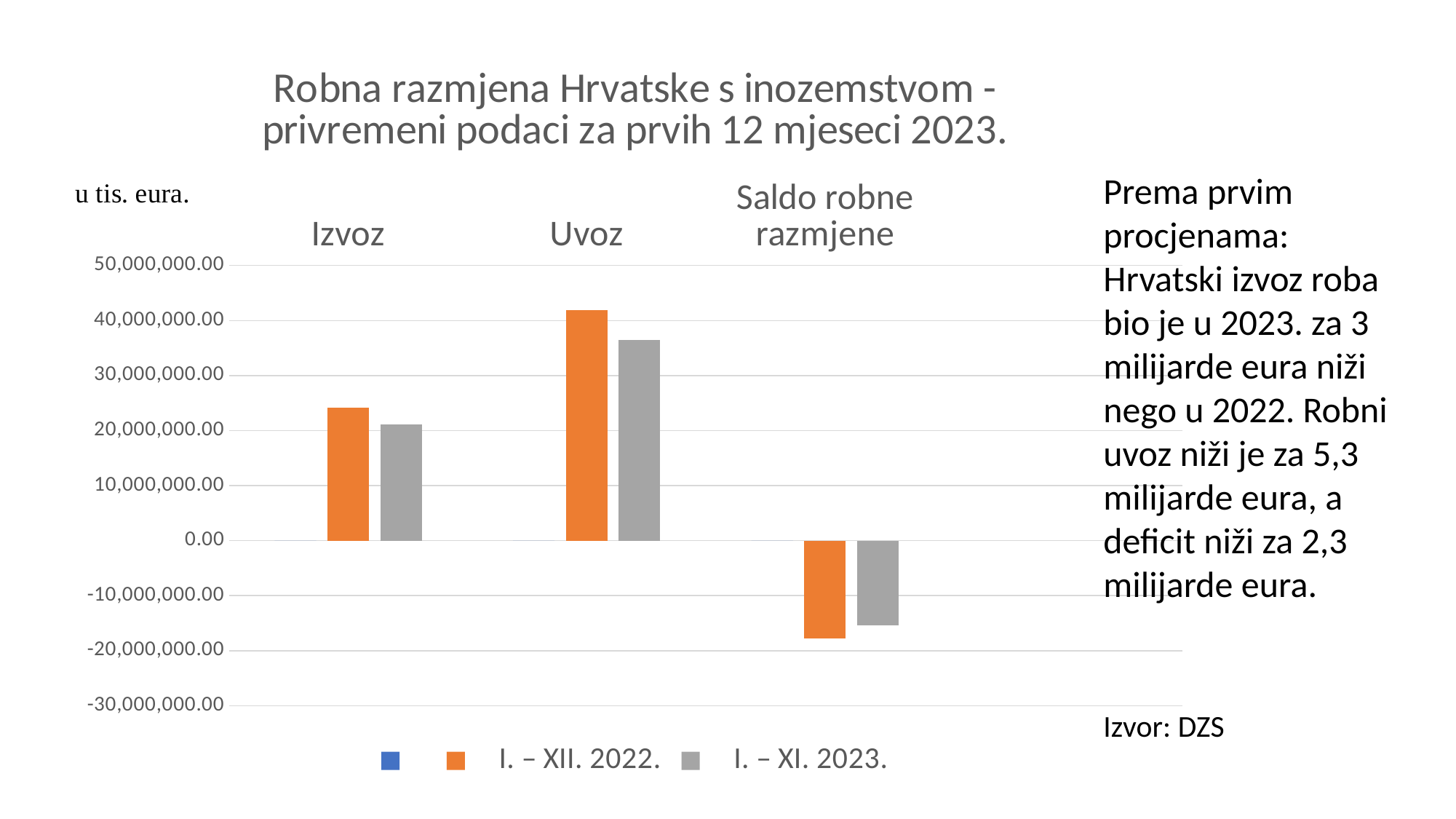
What kind of chart is shown on the slide? bar chart What colour are the bars for the I. – XI. 2023. series? gray For Uvoz, which series has the larger value: I. – XII. 2022. or I. – XI. 2023.? I. – XII. 2022. Is the value for Izvoz in the I. – XII. 2022. series greater or less than 20,000,000.00? greater Which category has the lowest value for the I. – XI. 2023. series? Saldo robne razmjene Is the value for Saldo robne razmjene in the I. – XII. 2022. series greater or less than -10,000,000.00? less What unit is stated above the vertical axis of the chart? u tis. eura. For Izvoz, which series has the larger value: I. – XII. 2022. or I. – XI. 2023.? I. – XII. 2022. Is the value for Izvoz in the I. – XI. 2023. series greater or less than 30,000,000.00? less How many categories are shown on the x axis of the chart? 3 Which category has the highest value for the I. – XII. 2022. series? Uvoz